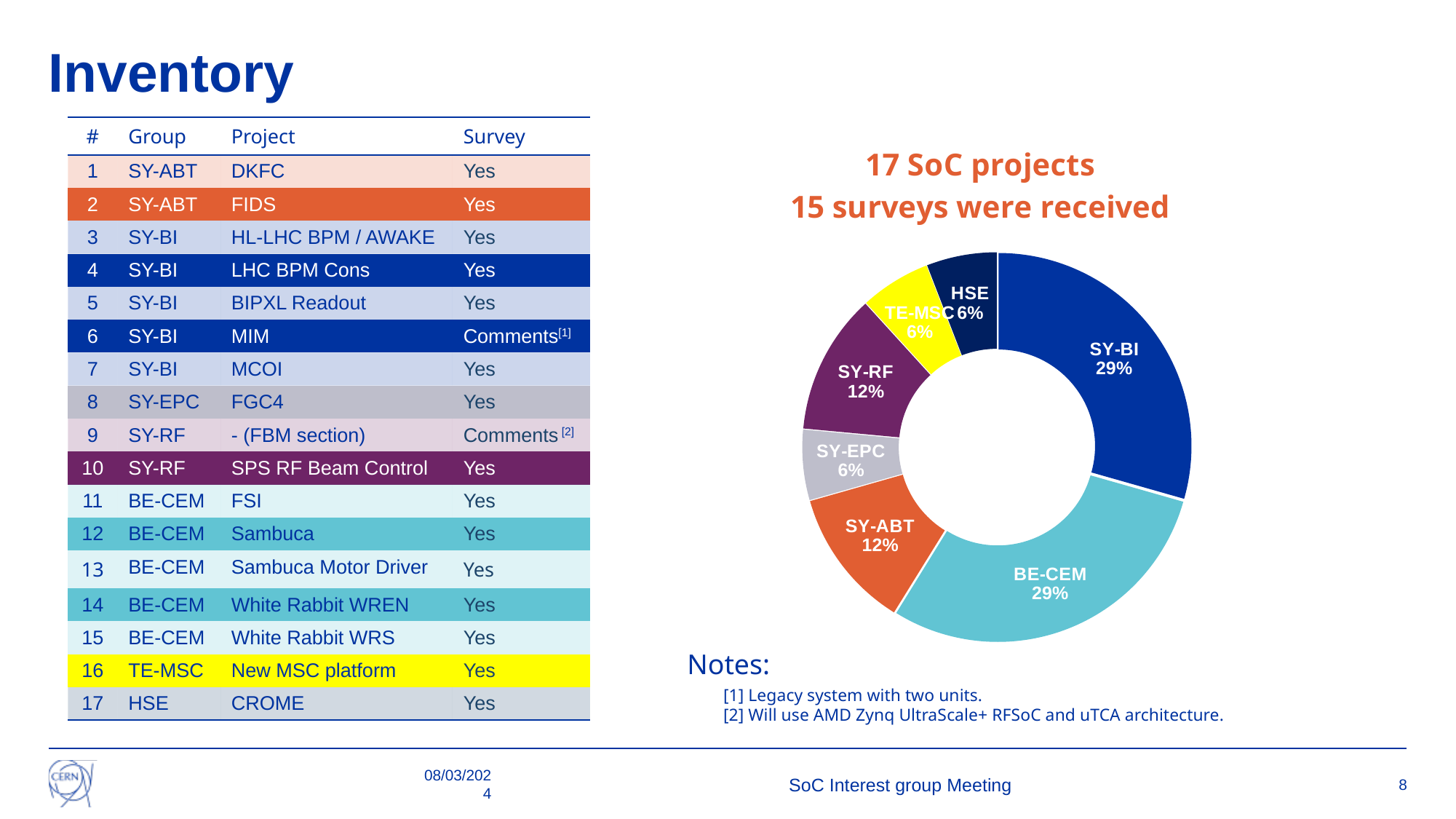
What colour is the SY-ABT slice in the pie chart? orange What percentage is shown for TE-MSC in the pie chart? 6% How many slices does the pie chart have? 7 By how many percentage points does SY-BI's share exceed SY-ABT's share in the pie chart? 17 percentage points What share is labelled for HSE in the pie chart? 6% Which has the larger share in the pie chart, SY-RF or SY-EPC? SY-RF What kind of chart is shown on the slide? pie chart (donut) What is the combined share of SY-BI and BE-CEM in the pie chart? 58% What is the value shown for SY-ABT in the pie chart? 12% What share of the pie chart does SY-BI account for? 29% What percentage is shown for BE-CEM in the pie chart? 29% What percentage does the pie chart show for SY-RF? 12%